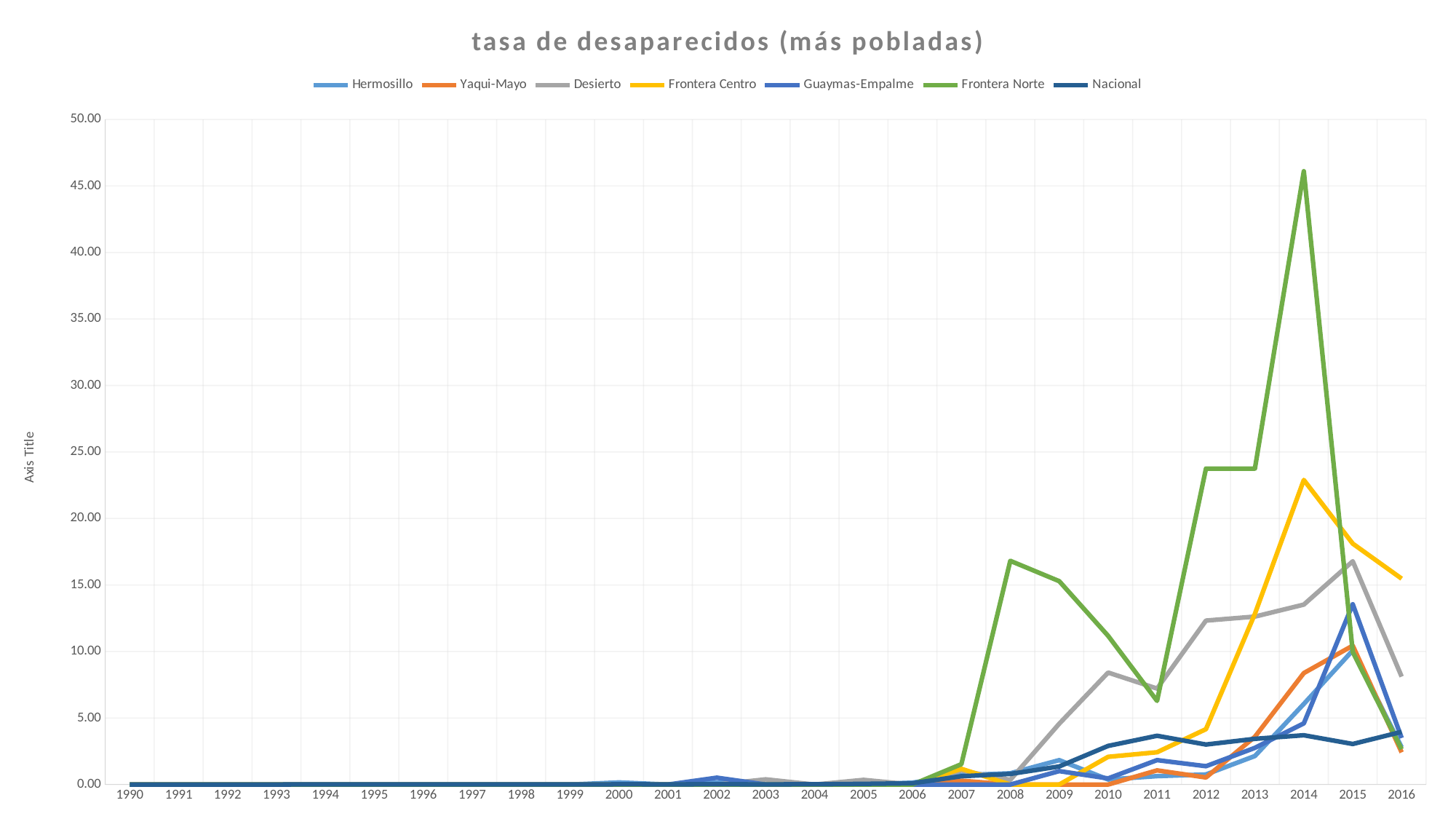
Does the Frontera Norte series rise or fall from 2014 to 2016? fall Which series reaches the highest value on the chart? Frontera Norte How many series does the legend list? 7 What is the title of the chart? tasa de desaparecidos (más pobladas) Is the value for Frontera Centro in 2014 greater or less than 20.00? greater In 2015, which is larger: Guaymas-Empalme or Yaqui-Mayo? Guaymas-Empalme How many years are plotted along the x axis? 27 Is the value for Nacional in 2016 greater or less than 5.00? less In 2016, which is larger: Frontera Centro or Desierto? Frontera Centro What kind of chart is shown on the slide? line chart Is the value for Frontera Norte in 2014 greater or less than 40.00? greater In which year does the Frontera Norte series reach its peak? 2014